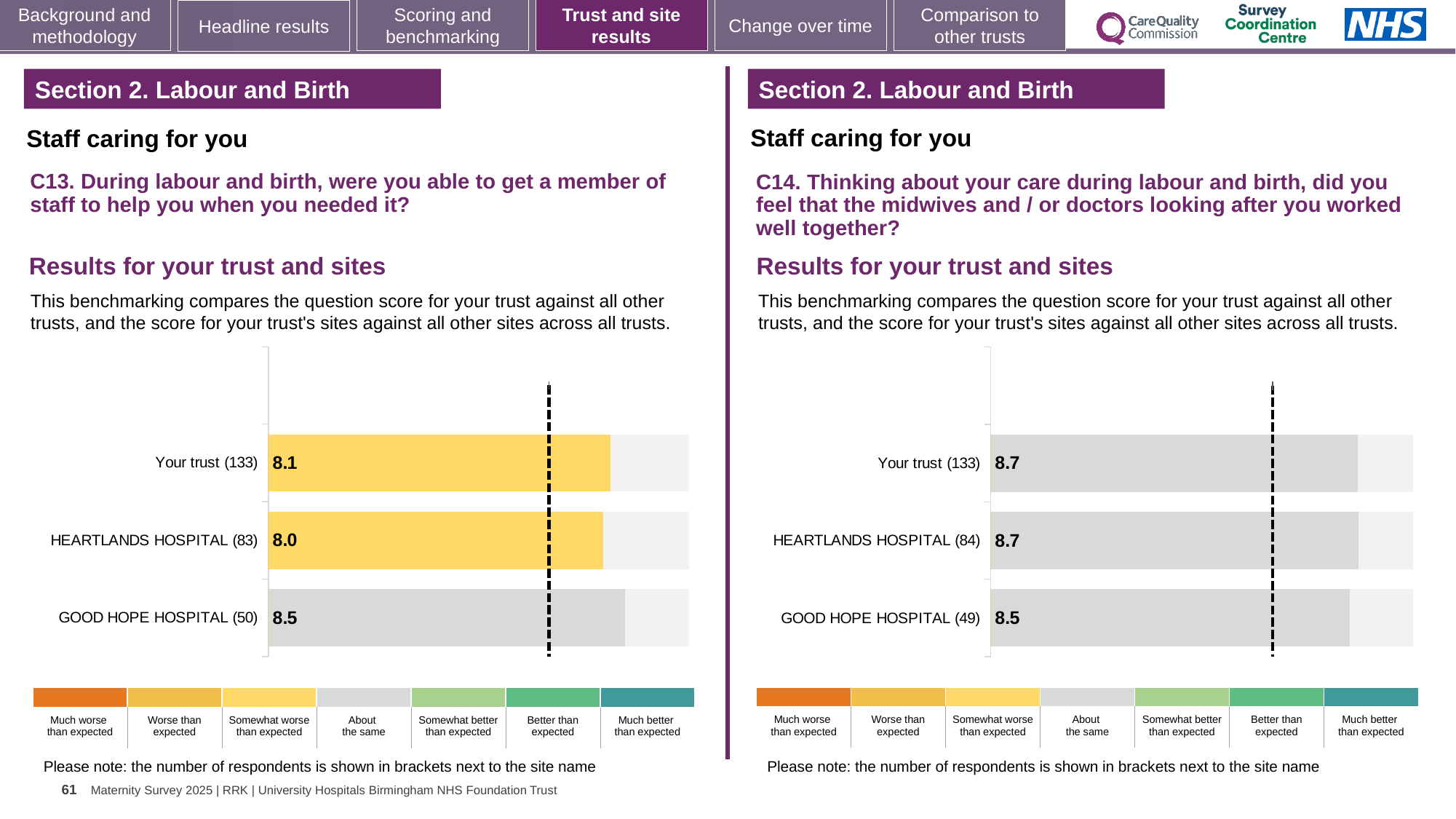
On the C13 chart (left), what is the difference between the scores for GOOD HOPE HOSPITAL and HEARTLANDS HOSPITAL? 0.5 On the C13 chart (left), what is the score for HEARTLANDS HOSPITAL? 8.0 On the C13 chart (left), what is the score for GOOD HOPE HOSPITAL? 8.5 On the C13 chart (left), which site or trust has the highest score? GOOD HOPE HOSPITAL On the C14 chart (right), what is the score for GOOD HOPE HOSPITAL? 8.5 What kind of chart is used on the C14 chart (right)? Bar chart On the C13 chart (left), what is the score for Your trust? 8.1 On the C14 chart (right), what is the score for Your trust? 8.7 On the C14 chart (right), how many respondents are shown in brackets for HEARTLANDS HOSPITAL? 84 On the C14 chart (right), which has the larger score, HEARTLANDS HOSPITAL or GOOD HOPE HOSPITAL? HEARTLANDS HOSPITAL On the C13 chart (left), which site or trust has the lowest score? HEARTLANDS HOSPITAL How many bars are plotted on the C13 chart (left)? 3